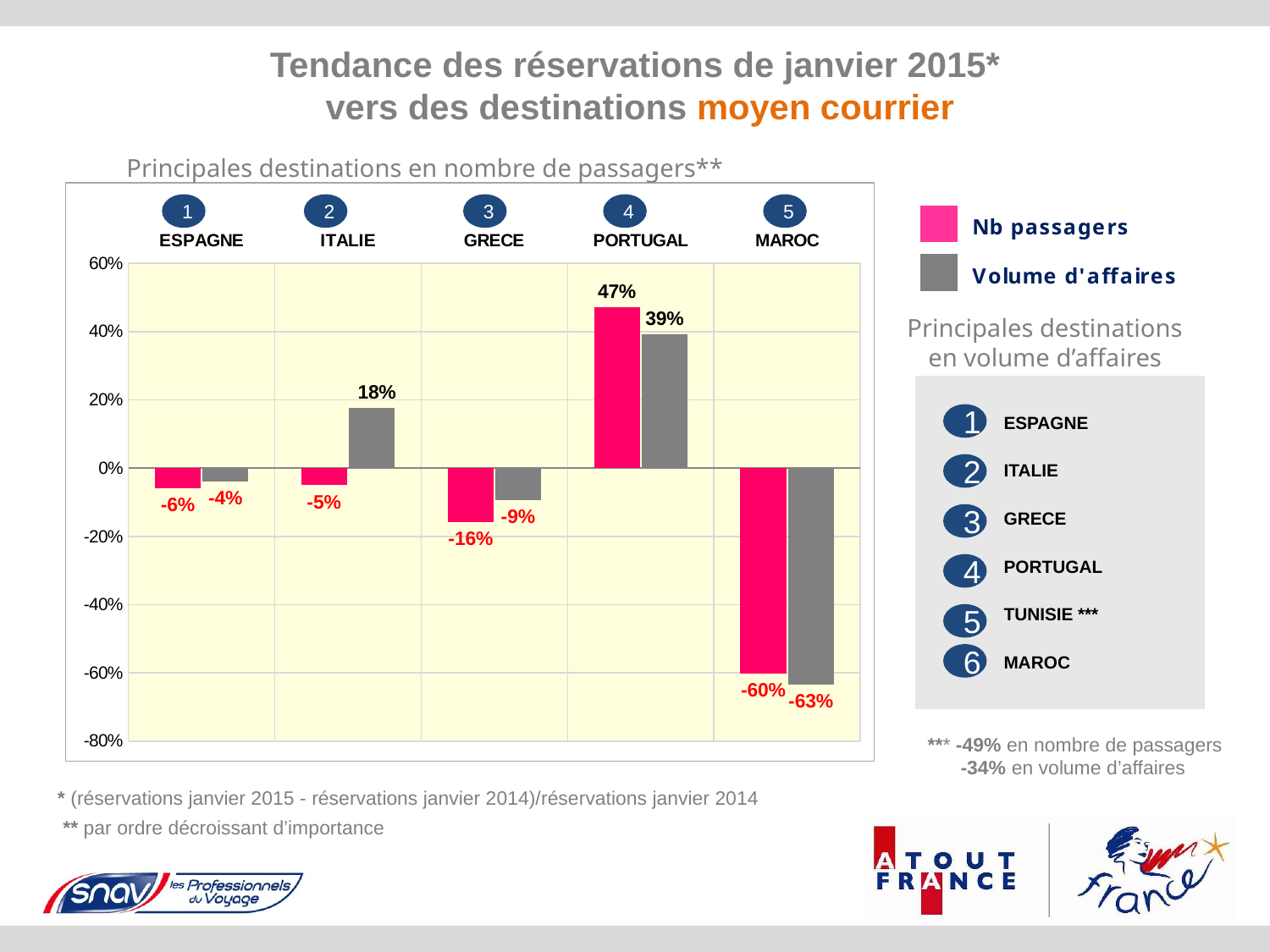
What is the Volume d'affaires value for MAROC? -63% Which colour represents the Nb passagers series in the chart? Pink Which destination has the highest Nb passagers value? PORTUGAL For ITALIE, which is larger: the Nb passagers value or the Volume d'affaires value? Volume d'affaires What is the Nb passagers value for PORTUGAL? 47% How many destinations are shown on the x axis of the chart? 5 How many series does the chart legend list? 2 What is the difference between the Nb passagers and Volume d'affaires values for PORTUGAL? 8 percentage points Which destination has the lowest Volume d'affaires value? MAROC What is the Nb passagers value for GRECE? -16% What kind of chart is shown on the slide? Bar chart What is the Volume d'affaires value for ITALIE? 18%